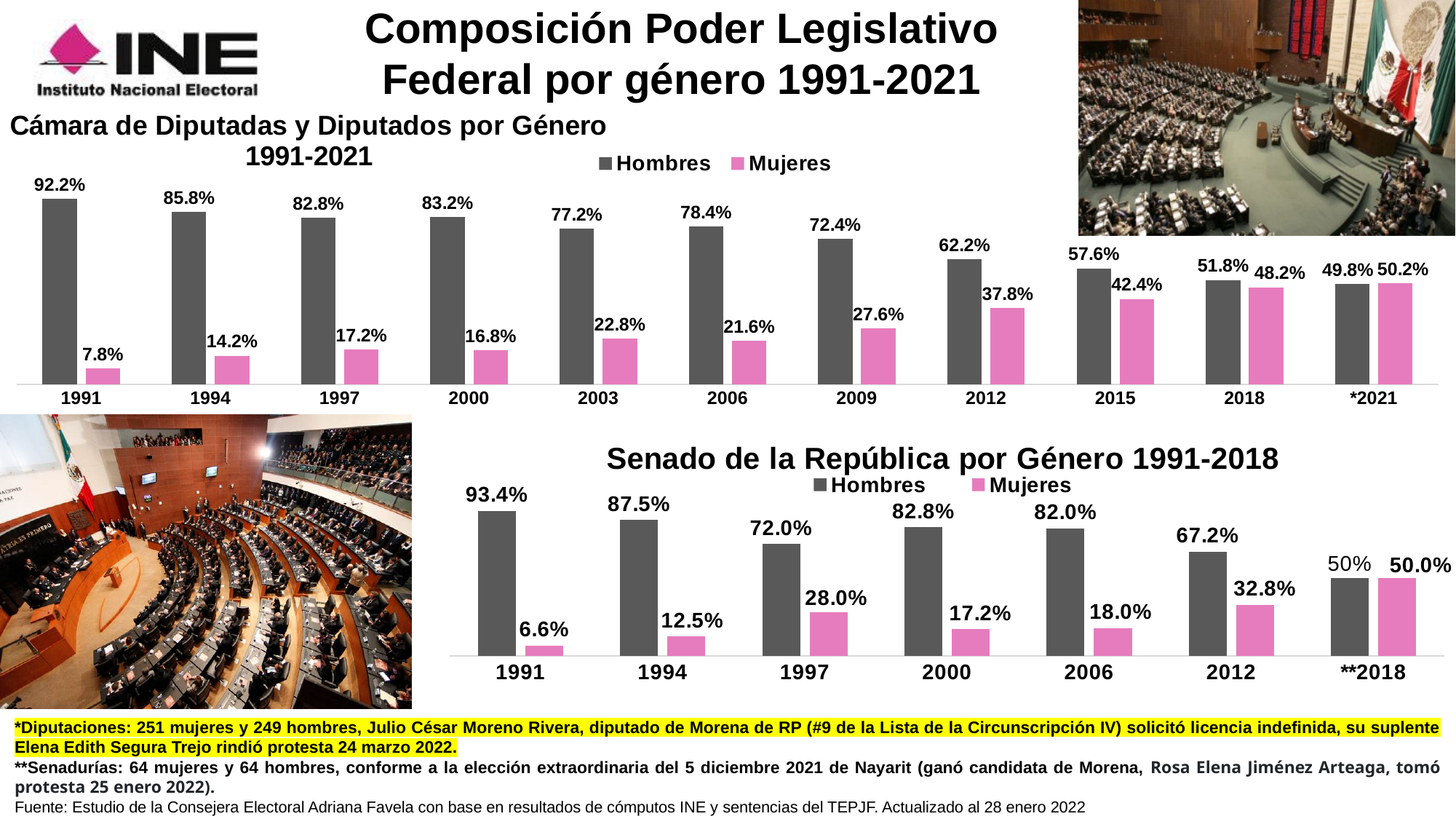
How many series does the legend of the 'Senado de la República por Género 1991-2018' chart list? 2 In the 'Senado de la República por Género 1991-2018' chart, what is the difference between Hombres and Mujeres in 2012? 34.4% What type of chart is the 'Senado de la República por Género 1991-2018' chart? bar chart In the 'Cámara de Diputadas y Diputados por Género 1991-2021' chart, what is the difference between Hombres and Mujeres in 2015? 15.2% In the 'Cámara de Diputadas y Diputados por Género 1991-2021' chart, what is the value for Mujeres in 1991? 7.8% In the 'Cámara de Diputadas y Diputados por Género 1991-2021' chart, how many years are shown on the x axis? 11 In the 'Senado de la República por Género 1991-2018' chart, what is the value for Mujeres in 1997? 28.0% In the 'Senado de la República por Género 1991-2018' chart, which is larger in 2000: Hombres or Mujeres? Hombres In the 'Cámara de Diputadas y Diputados por Género 1991-2021' chart, which year has the highest value for Mujeres? *2021 In the 'Cámara de Diputadas y Diputados por Género 1991-2021' chart, does the value for Mujeres rise or fall from 1991 to 2021? rise In the 'Cámara de Diputadas y Diputados por Género 1991-2021' chart, what is the value for Hombres in 2012? 62.2% In the 'Senado de la República por Género 1991-2018' chart, which year has the lowest value for Mujeres? 1991